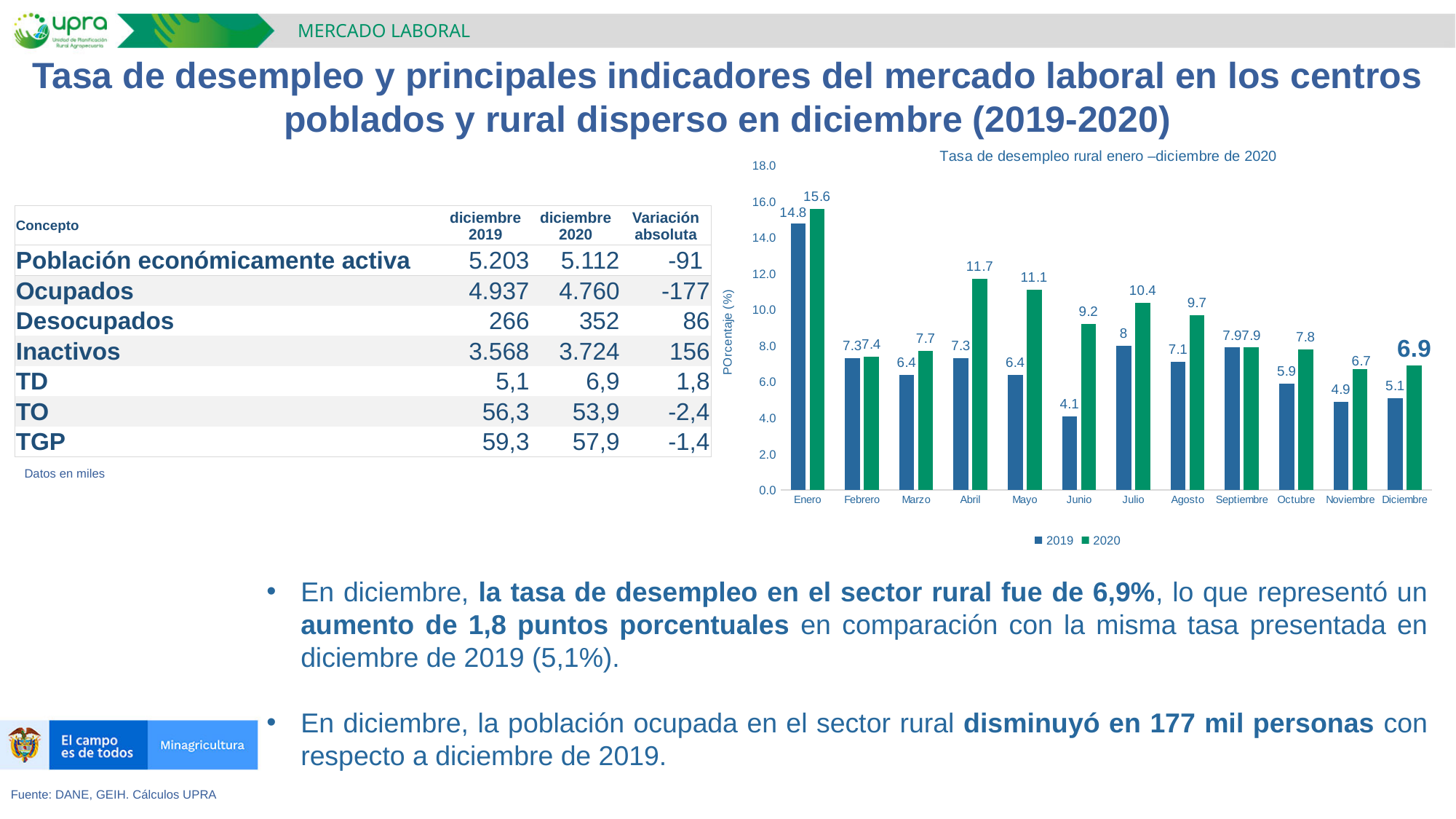
How many months are shown on the x axis? 12 What is the difference between the 2020 and 2019 values for Diciembre? 1.8 What is the 2020 unemployment rate for Enero? 15.6 Which month has the lowest 2019 value? Junio What is the 2019 unemployment rate for Junio? 4.1 Is the 2019 value for Enero greater or less than 14.0? greater What type of chart is shown? Bar chart Which is larger, the 2020 value for Julio or the 2020 value for Agosto? Julio How many series does the legend list? 2 What is the difference between the 2020 and 2019 values for Mayo? 4.7 Which month has the highest 2020 value? Enero What is the 2020 value for Abril? 11.7